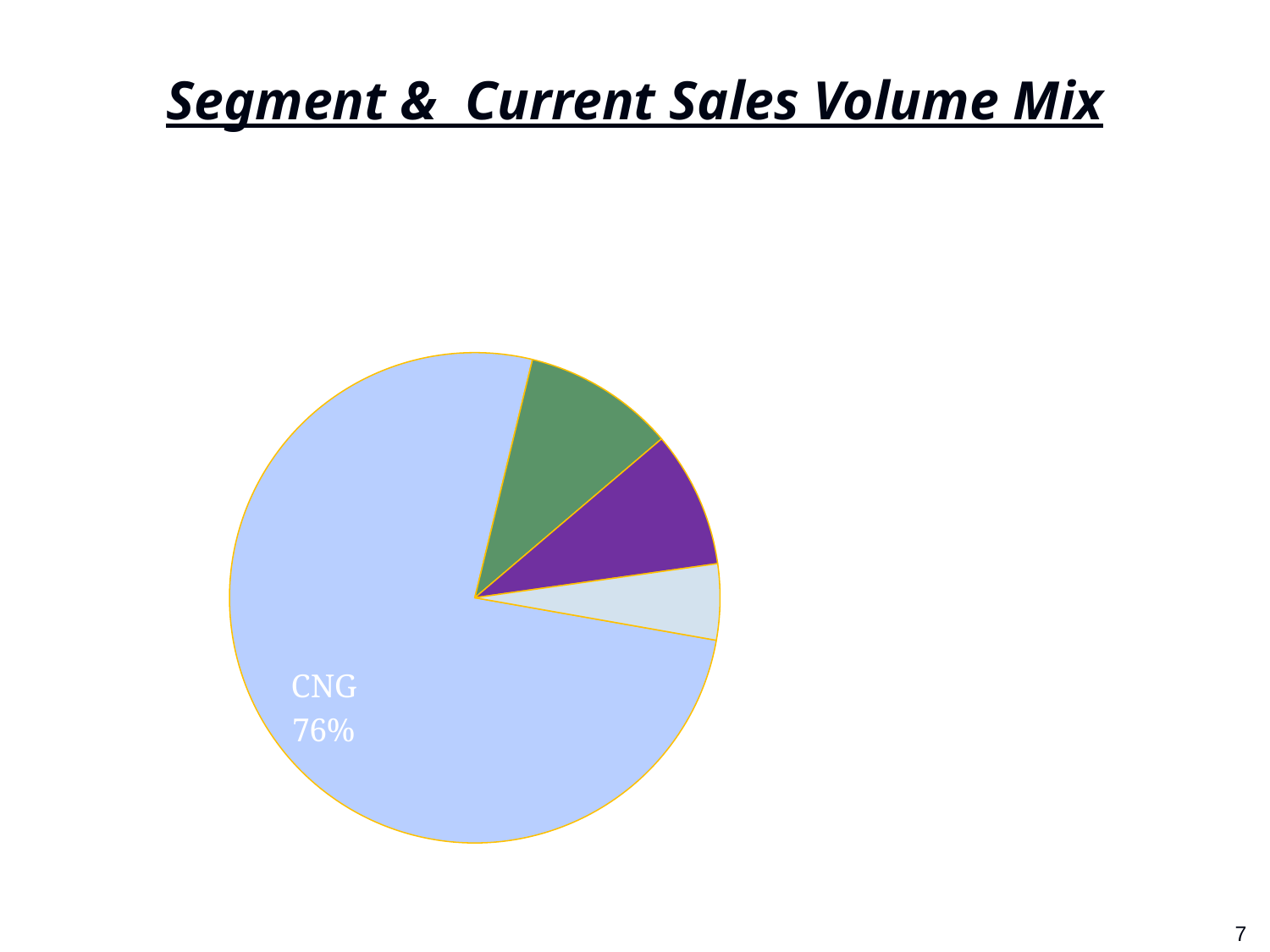
What is the title of the slide containing the pie chart? Segment & Current Sales Volume Mix How many slices does the pie chart have? 4 What colour is the CNG slice in the pie chart? light blue What kind of chart is shown on the slide? pie chart Is the share for CNG greater or less than 50%? greater What share of the pie does the CNG slice represent? 76% Which slice of the pie chart is the largest? CNG What is the value shown for CNG in the pie chart? 76%